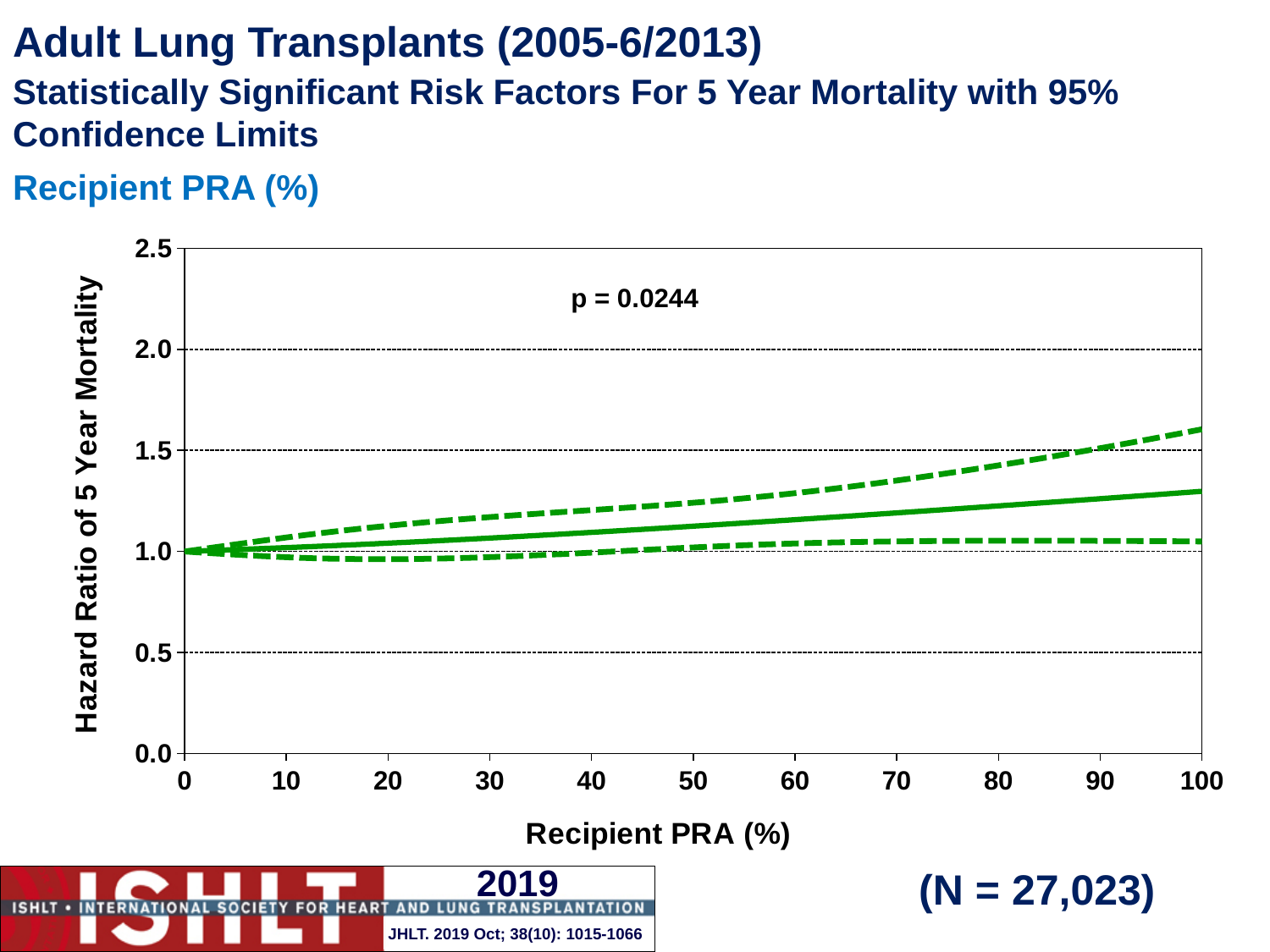
What is the label of the y axis? Hazard Ratio of 5 Year Mortality What kind of chart is shown on the slide? line chart What is the highest value shown on the y axis? 2.5 Does the solid hazard ratio line rise or fall as Recipient PRA (%) increases from 0 to 100? rise Is the upper dashed confidence limit at a Recipient PRA of 100% greater or less than 1.5? greater Is the lower dashed confidence limit at a Recipient PRA of 20% greater or less than 1.0? less What is the highest value shown on the x axis? 100 What p-value is printed on the chart? p = 0.0244 What is the hazard ratio of 5 year mortality at a Recipient PRA of 0%? 1.0 Is the hazard ratio on the solid line at a Recipient PRA of 100% greater or less than 1.0? greater How many lines are plotted on the chart? 3